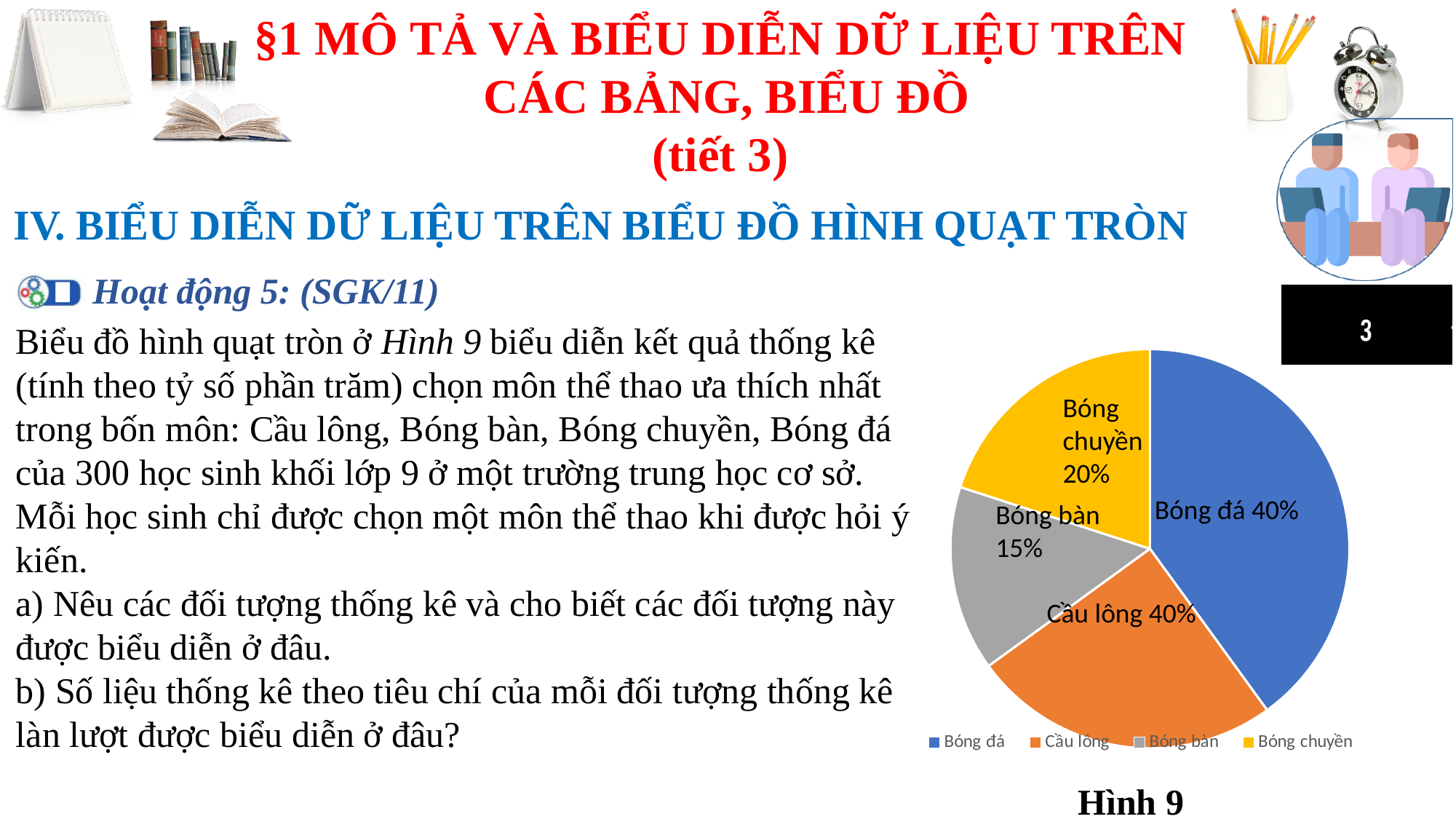
Which slice is larger in the pie chart, Bóng đá or Bóng bàn? Bóng đá What colour is the Bóng chuyền slice in the pie chart? yellow What is the difference between the percentages for Bóng chuyền and Bóng bàn in the pie chart? 5% How many slices does the pie chart have? 4 Which slice is larger in the pie chart, Bóng chuyền or Bóng bàn? Bóng chuyền Which sport has the smallest slice in the pie chart? Bóng bàn What percentage of the pie chart is labelled for Bóng đá? 40% How many entries does the legend of the pie chart list? 4 What percentage is shown for Bóng chuyền in the pie chart? 20% What is the caption (figure name) given below the pie chart? Hình 9 What percentage is shown for Bóng bàn in the pie chart? 15% What kind of chart is shown on the slide? pie chart